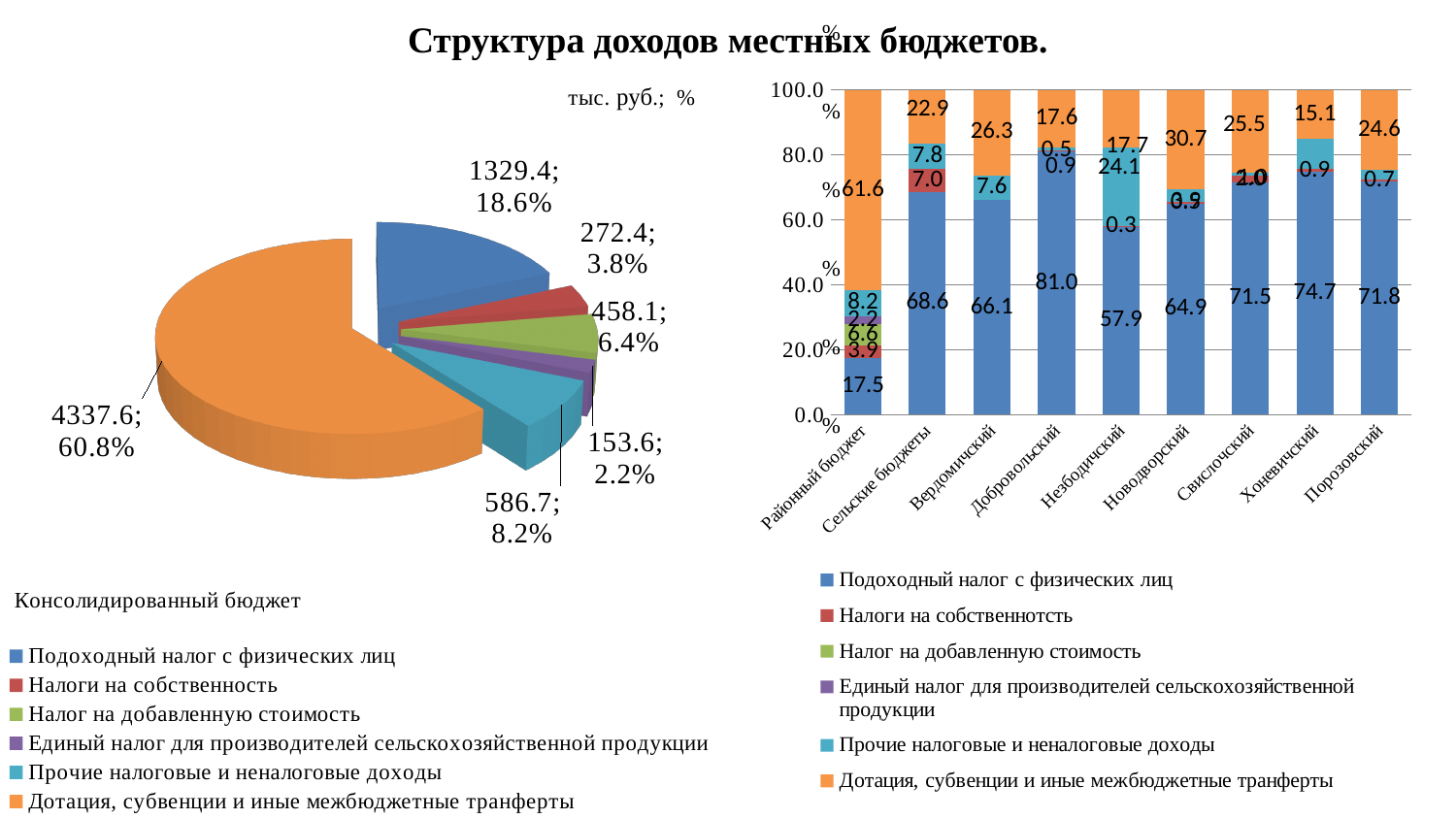
In the stacked bar chart on the right, what is the value of Подоходный налог с физических лиц for Добровольский? 81.0 In the stacked bar chart on the right, which category has the highest value for Подоходный налог с физических лиц? Добровольский In the stacked bar chart on the right, which category has the lowest value for Подоходный налог с физических лиц? Районный бюджет In the pie chart on the left, what value and share are shown for the largest (orange) slice? 4337.6; 60.8% In the pie chart on the left, which slice is the smallest? Единый налог для производителей сельскохозяйственной продукции (153.6; 2.2%) In the pie chart on the left, what share does the blue slice (Подоходный налог с физических лиц) have? 18.6% In the pie chart on the left, how many slices are there? 6 In the pie chart on the left, what is the difference between the values 586.7 and 458.1? 128.6 In the stacked bar chart on the right, how many series does the legend list? 6 In the stacked bar chart on the right, how many categories are shown on the x axis? 9 In the stacked bar chart on the right, what is the value of Дотация, субвенции и иные межбюджетные трансферты for Районный бюджет? 61.6 What type of chart is shown on the right side of the slide? Stacked bar chart